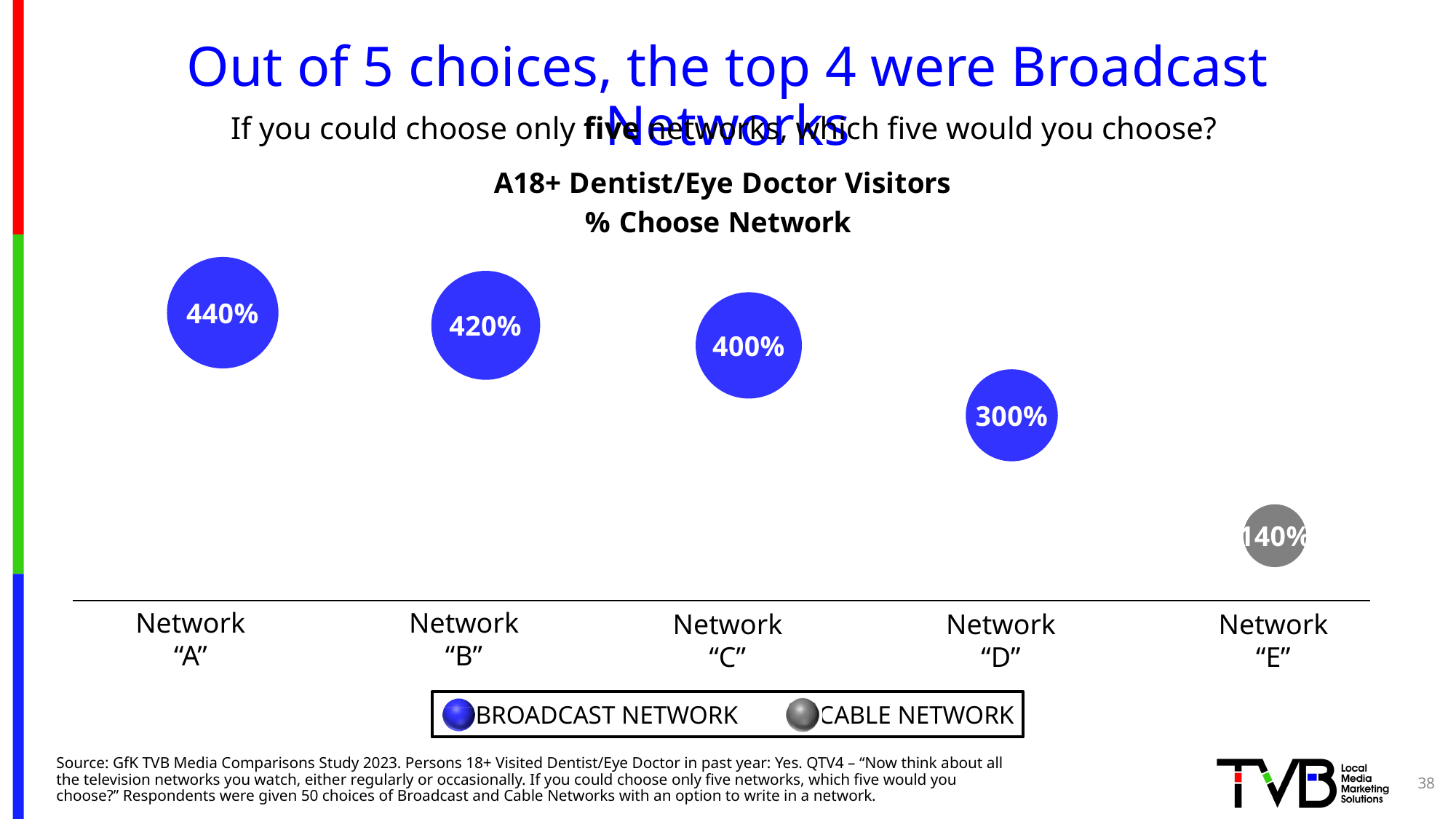
What is the difference between the values for Network "B" and Network "C"? 20% Do the values rise or fall from Network "A" to Network "E"? fall Which network has the highest value? Network "A" What is the value for Network "A"? 440% Which has a larger value, Network "C" or Network "D"? Network "C" What is the value for Network "E"? 140% Which network has the lowest value? Network "E" Which network is shown as a Cable Network in the chart? Network "E" How many entries does the legend list? 2 What is the difference between the values for Network "D" and Network "E"? 160% How many networks are plotted on the chart? 5 What is the value for Network "D"? 300%